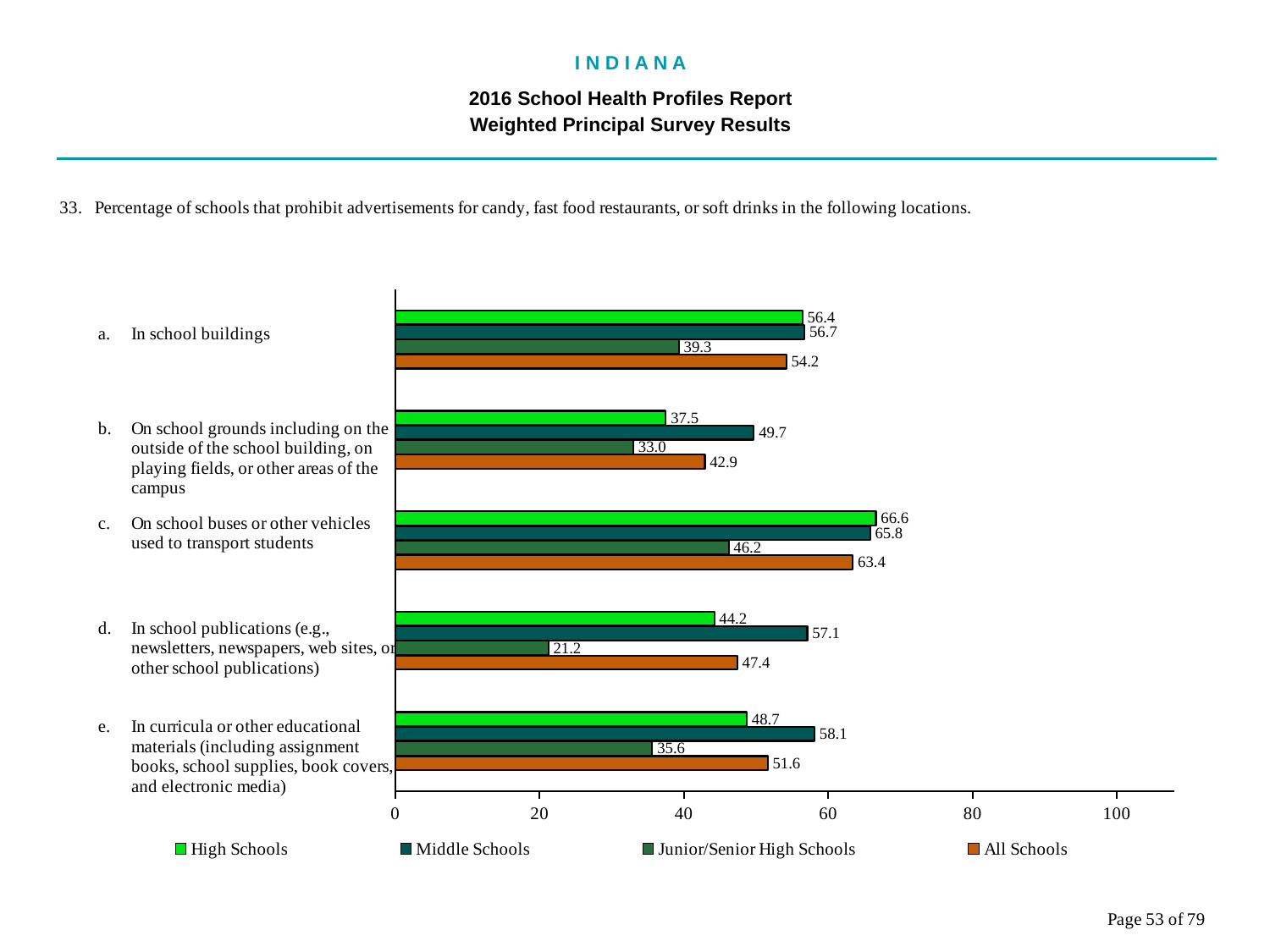
Which location has the highest value for Middle Schools? On school buses or other vehicles used to transport students For 'On school grounds', which is larger: the High Schools value or the Middle Schools value? Middle Schools Which series is shown in orange in the legend? All Schools How many locations (categories) are shown in the chart? 5 Which location has the lowest value for All Schools? On school grounds including on the outside of the school building, on playing fields, or other areas of the campus What is the difference between the Middle Schools and High Schools values for 'In curricula or other educational materials'? 9.4 What is the value for High Schools for 'In school buildings'? 56.4 What is the value for Junior/Senior High Schools for 'In school publications'? 21.2 How many series does the legend list? 4 What is the value for All Schools for 'On school buses or other vehicles used to transport students'? 63.4 Is the value for High Schools for 'On school buses or other vehicles' greater or less than 60? greater What kind of chart is shown on the slide? bar chart